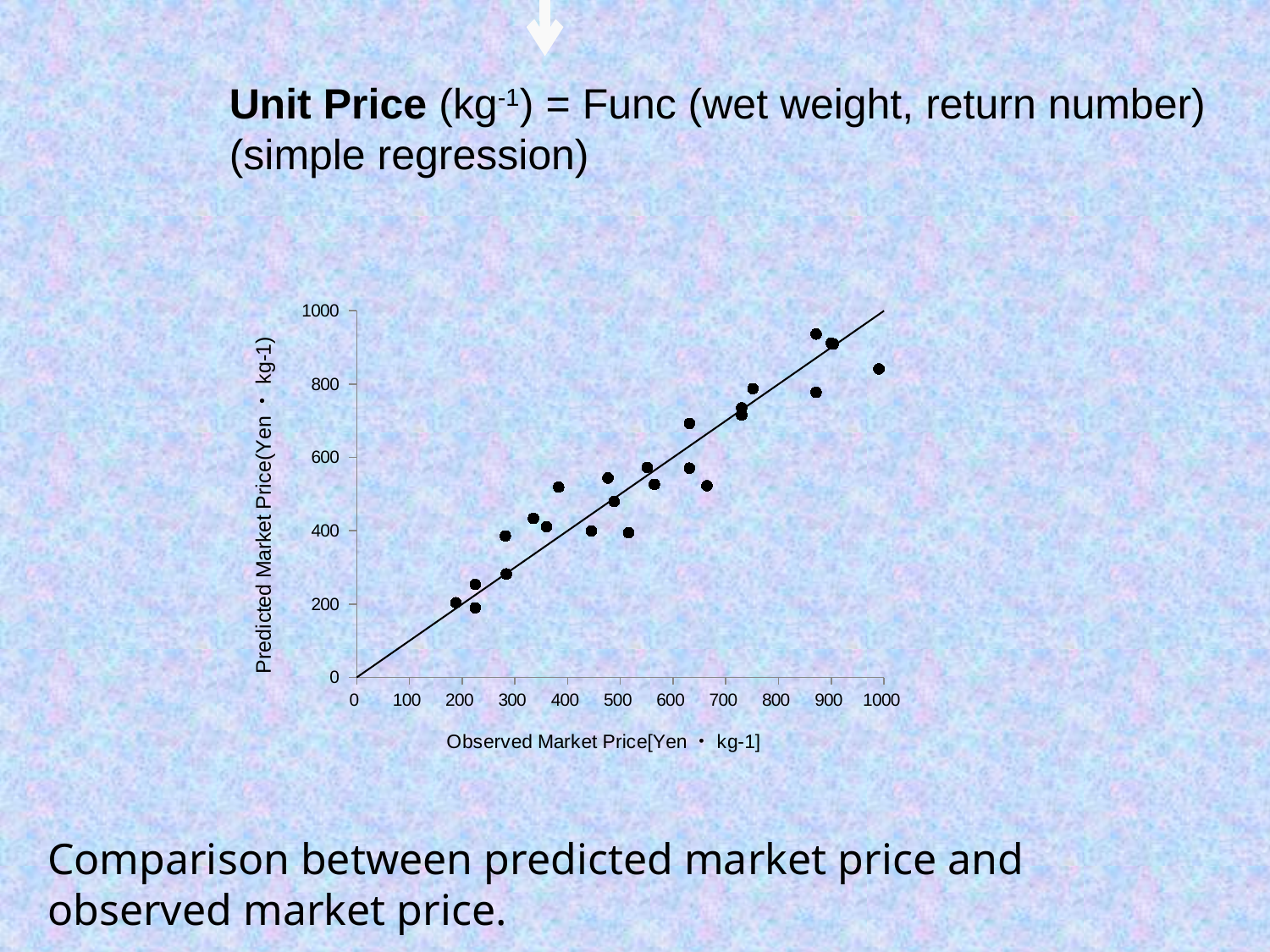
Is the highest predicted market price plotted on the chart greater or less than 900? greater What is the title of the y axis of the chart? Predicted Market Price(Yen・kg-1) What is the title of the x axis of the chart? Observed Market Price[Yen・kg-1] As the observed market price increases along the x axis, does the predicted market price generally rise or fall? rise What is the maximum value shown on the x axis of the chart? 1000 What kind of chart is shown on the slide? scatter plot What is the interval between tick marks on the y axis of the chart? 200